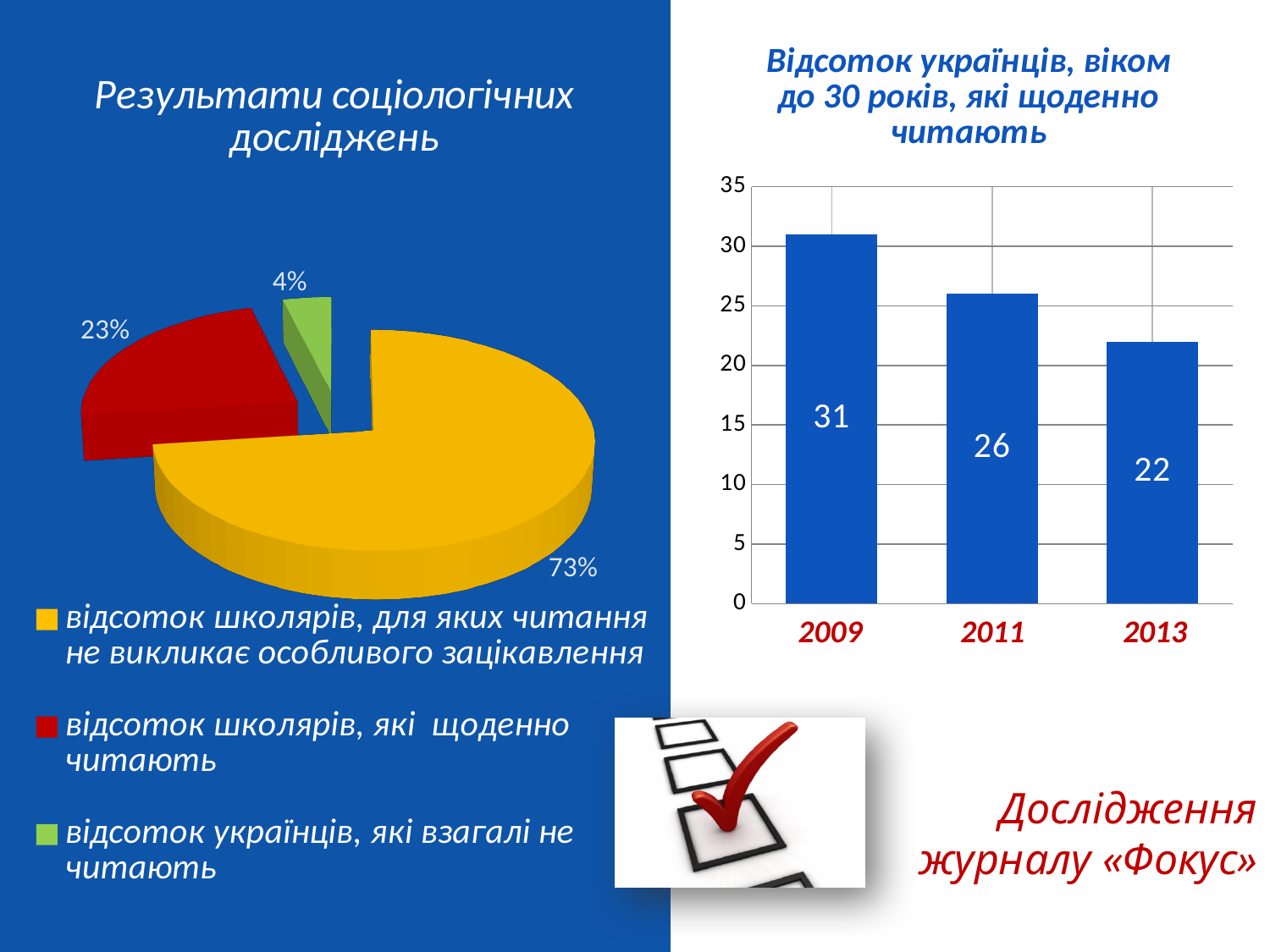
In the bar chart on the right, how many bars are plotted? 3 In the bar chart on the right, which year has the lowest value? 2013 In the pie chart on the left, what colour is the slice for 'відсоток школярів, які щоденно читають'? red In the bar chart on the right, what is the difference between the values for 2009 and 2011? 5 In the pie chart on the left, how many slices are there? 3 In the bar chart on the right, do the values rise or fall from 2009 to 2013? fall What kind of chart is shown on the right side of the slide? bar chart In the pie chart on the left, what share is shown for 'відсоток школярів, які щоденно читають'? 23% In the pie chart on the left, which category has the largest slice? відсоток школярів, для яких читання не викликає особливого зацікавлення In the bar chart on the right, what is the value for 2013? 22 In the bar chart titled 'Відсоток українців, віком до 30 років, які щоденно читають', what is the value for 2009? 31 In the pie chart on the left, what share is shown for 'відсоток українців, які взагалі не читають'? 4%